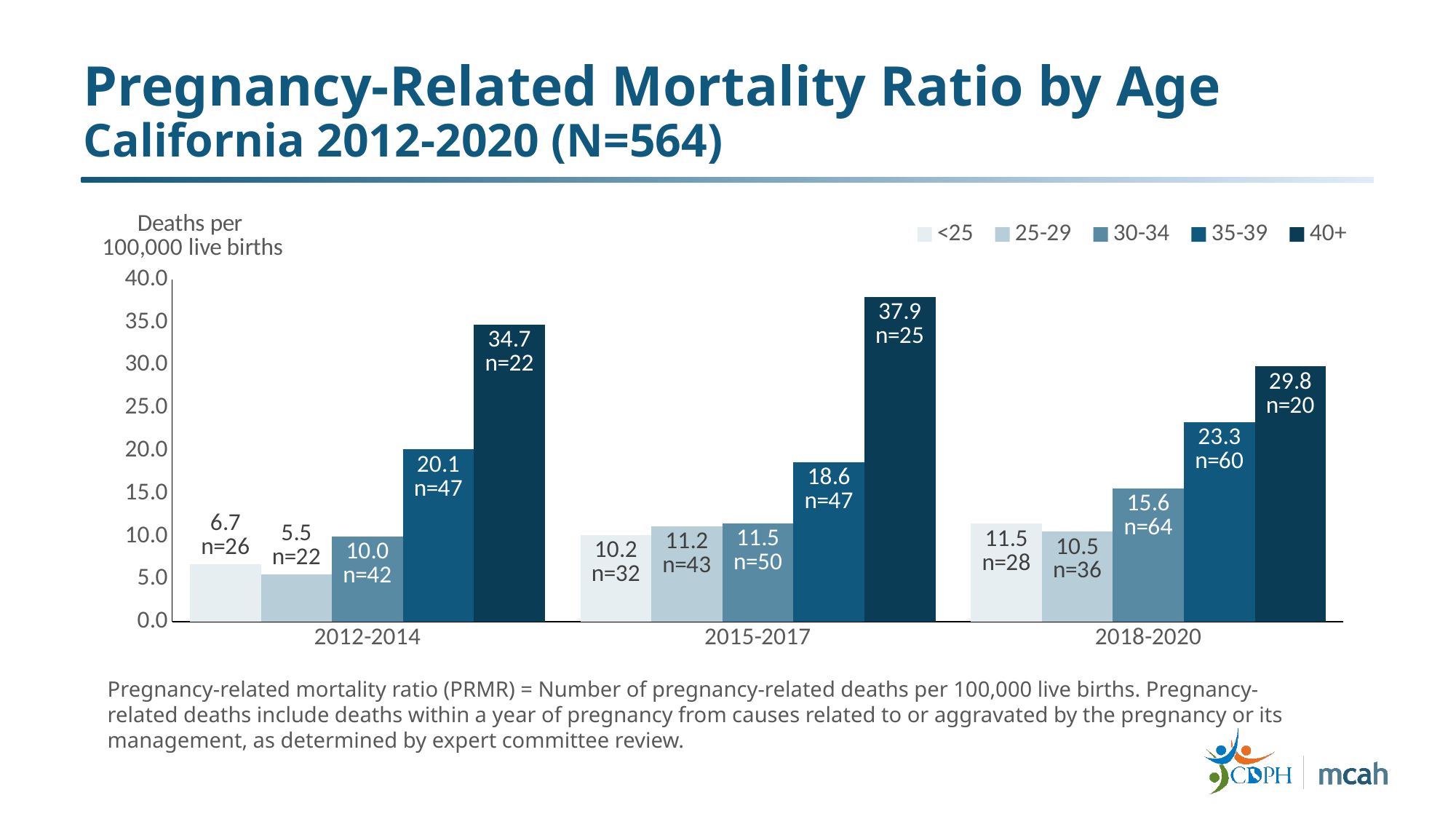
Which is larger: the 30-34 mortality ratio in 2015-2017 or the 30-34 mortality ratio in 2018-2020? 2018-2020 Which age group has the highest mortality ratio in 2012-2014? 40+ What is the y-axis label of the chart? Deaths per 100,000 live births What is the difference between the 40+ and 35-39 mortality ratios in 2015-2017? 19.3 What kind of chart is shown on the slide? Bar chart What is the pregnancy-related mortality ratio for the <25 age group in 2012-2014? 6.7 How many deaths (n) are reported for the 30-34 age group in 2018-2020? n=64 What is the pregnancy-related mortality ratio for the 40+ age group in 2015-2017? 37.9 What is the pregnancy-related mortality ratio for the 35-39 age group in 2018-2020? 23.3 How many time periods are shown on the x axis? 3 How many age groups does the legend list? 5 Which age group has the lowest mortality ratio in 2012-2014? 25-29